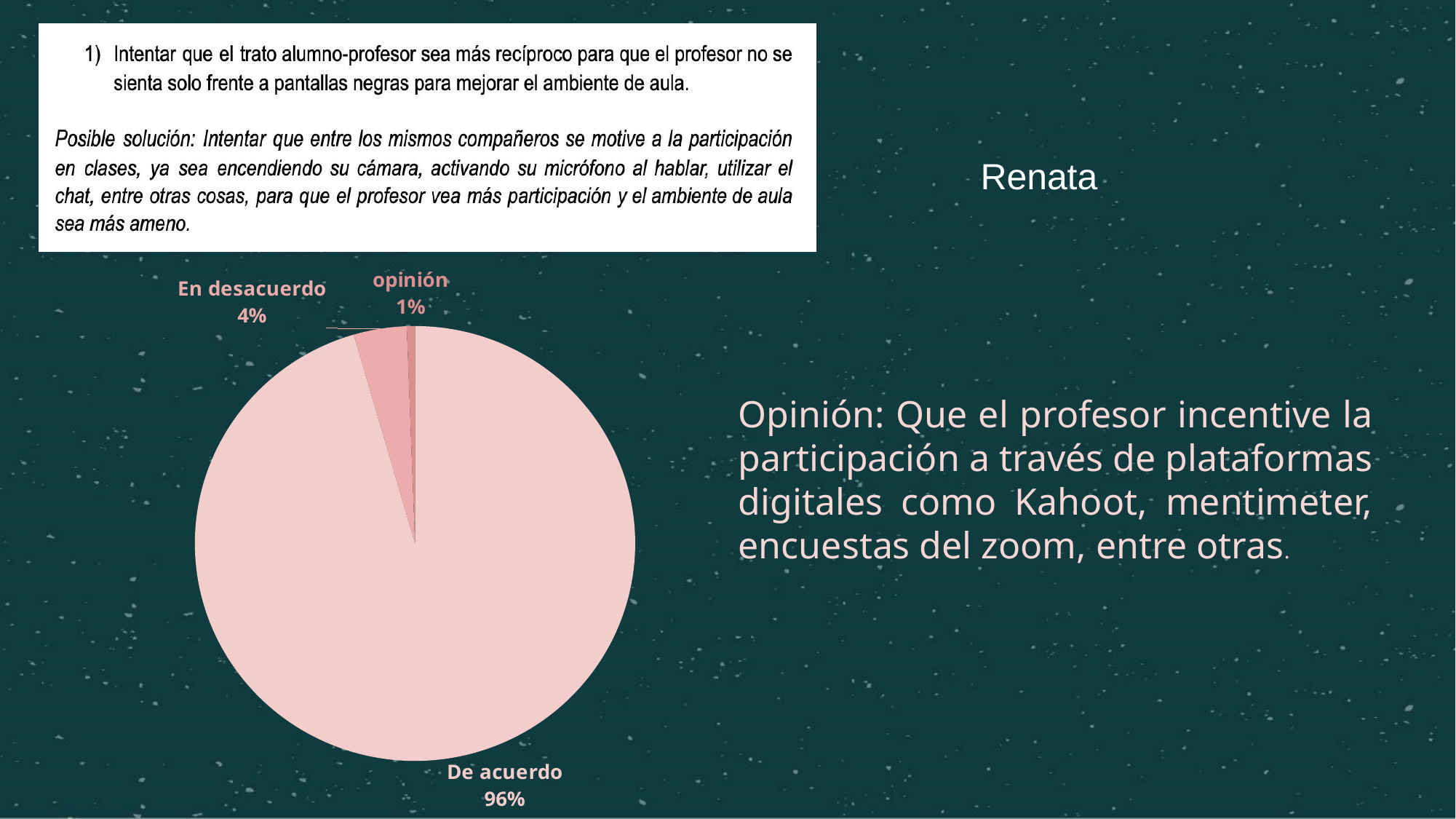
What percentage of the pie chart is labelled "En desacuerdo"? 4% What percentage of the pie chart is labelled "De acuerdo"? 96% Which slice of the pie chart is the smallest? opinión How many slices does the pie chart have? 3 What kind of chart is shown on the slide? pie chart What is the difference in percentage points between the "En desacuerdo" slice and the "opinión" slice? 3 Which slice of the pie chart is the largest? De acuerdo What is the difference in percentage points between the "De acuerdo" slice and the "En desacuerdo" slice? 92 What name appears on the slide above the opinion text, to the right of the pie chart? Renata What share of the pie does the "De acuerdo" slice represent? 96% Which is larger in the pie chart, "En desacuerdo" or "opinión"? En desacuerdo What percentage of the pie chart is labelled "opinión"? 1%